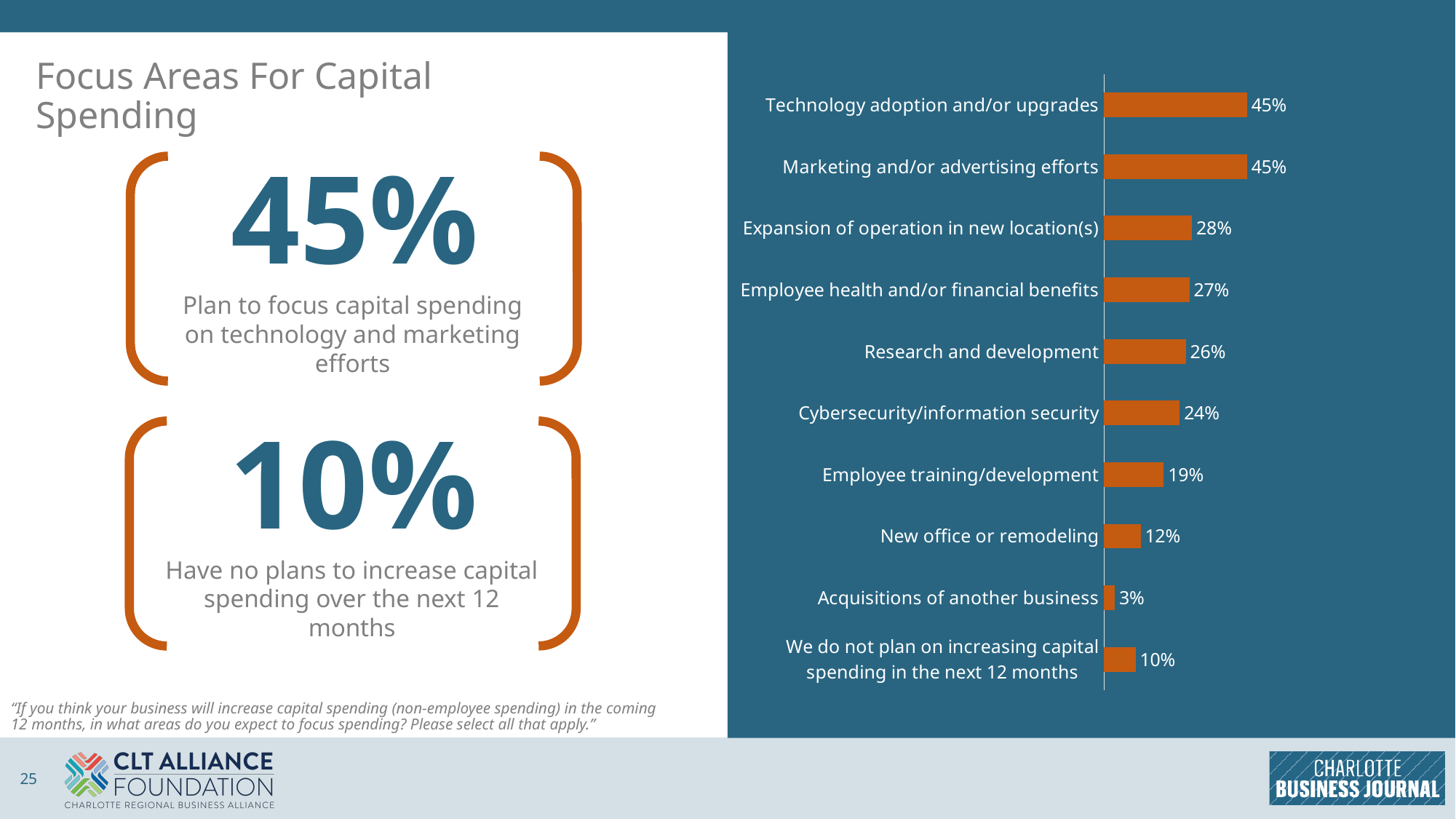
What is the difference between Marketing and/or advertising efforts and New office or remodeling? 33% What is the value for Technology adoption and/or upgrades? 45% How many categories are shown in the chart? 10 What is the value for Acquisitions of another business? 3% Which category has the lowest value? Acquisitions of another business What is the value for Cybersecurity/information security? 24% What is the difference between Employee health and/or financial benefits and Employee training/development? 8% Which is larger, Research and development or Employee training/development? Research and development What kind of chart is shown on the slide? Bar chart Which is larger, New office or remodeling or We do not plan on increasing capital spending in the next 12 months? New office or remodeling What is the value for Expansion of operation in new location(s)? 28% What colour are the bars in the chart? Orange